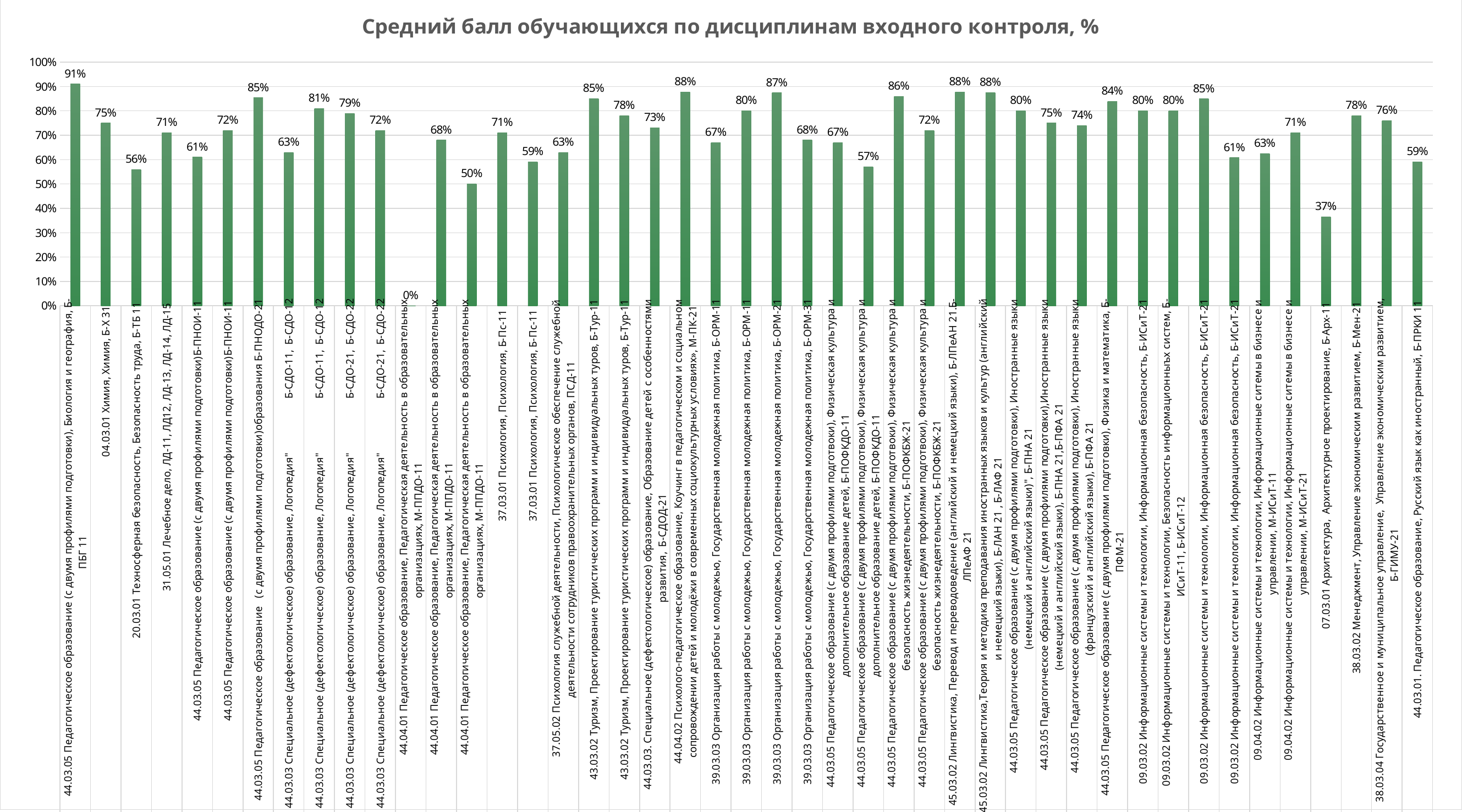
What is the value for 44.04.02 Психолого-педагогическое образование, М-ПК-21? 88% Which category has the highest value? 44.03.05 Педагогическое образование (с двумя профилями подготовки), Биология и география, Б-ПБГ 11 Which is larger: the value for 39.03.03 Организация работы с молодежью, Б-ОРМ-21 or for Б-ОРМ-31? Б-ОРМ-21 What type of chart is shown on the slide? Bar chart What is the difference between the values for 38.03.02 Менеджмент, Б-Мен-21 and 38.03.04 Государственное и муниципальное управление, Б-ГИМУ-21? 2% What is the highest value shown on the chart? 91% What is the difference between the values for 44.03.05 Педагогическое образование, Физика и математика, Б-ПФМ-21 and 44.03.01. Педагогическое образование, Русский язык как иностранный, Б-ПРКИ 11? 25% Is the value for 20.03.01 Техносферная безопасность, Безопасность труда, Б-ТБ 11 greater or less than 60%? less What is the value for 04.03.01 Химия, Б-Х 31? 75% What is the value for 38.03.04 Государственное и муниципальное управление, Б-ГИМУ-21? 76% What is the value for 07.03.01 Архитектура, Архитектурное проектирование, Б-Арх-11? 37% What is the title of the chart? Средний балл обучающихся по дисциплинам входного контроля, %